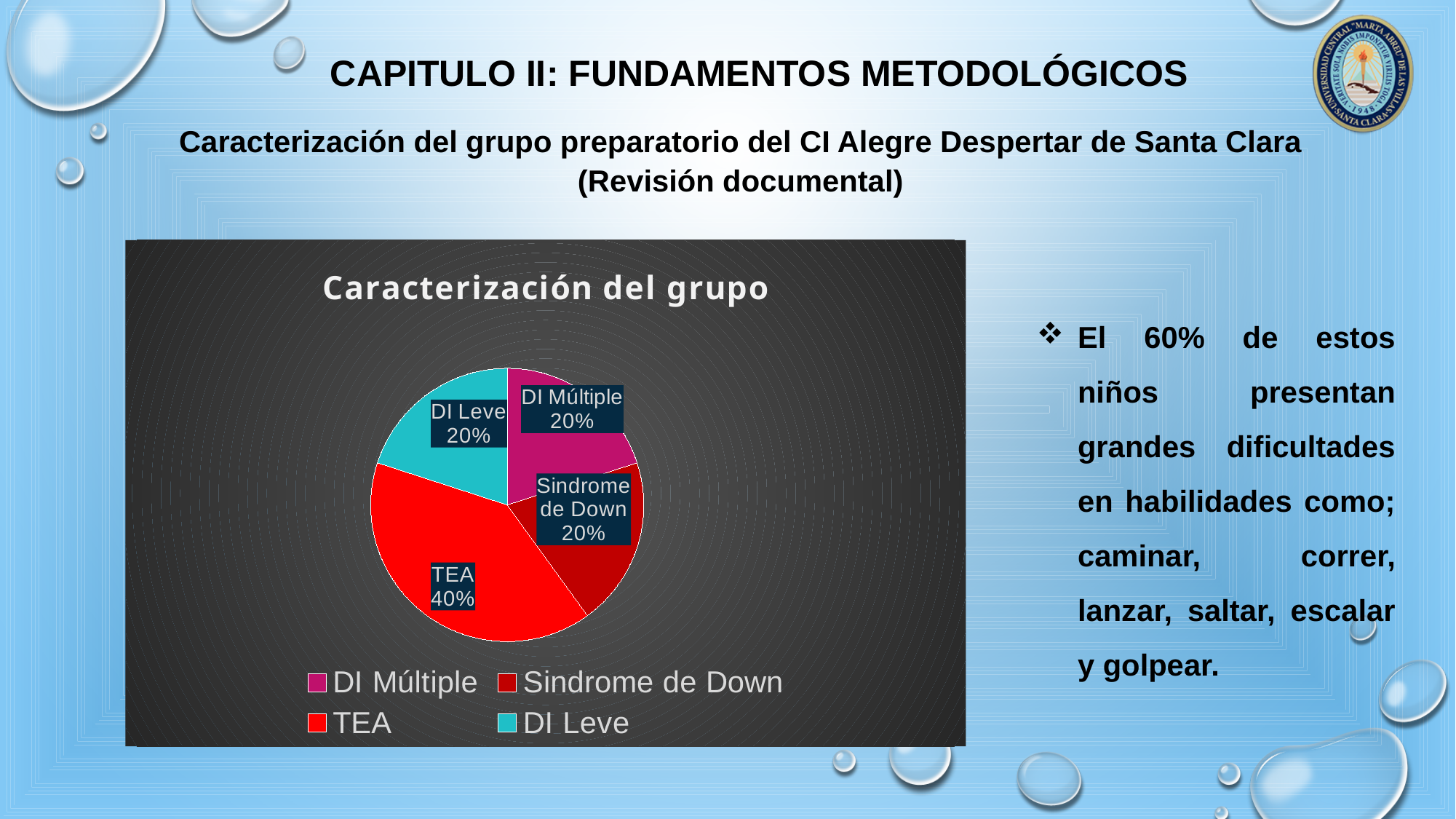
What share of the pie does Sindrome de Down represent? 20% Which is larger, the share for TEA or the share for Sindrome de Down? TEA What colour is the TEA slice in the pie chart? red What kind of chart is shown on the slide? pie chart What share of the pie does TEA represent? 40% What share of the pie does DI Múltiple represent? 20% How many entries does the legend list? 4 What is the title of the chart? Caracterización del grupo How many categories are shown in the pie chart? 4 What is the difference between the share for TEA and the share for DI Leve? 20% Which category has the largest slice of the pie? TEA